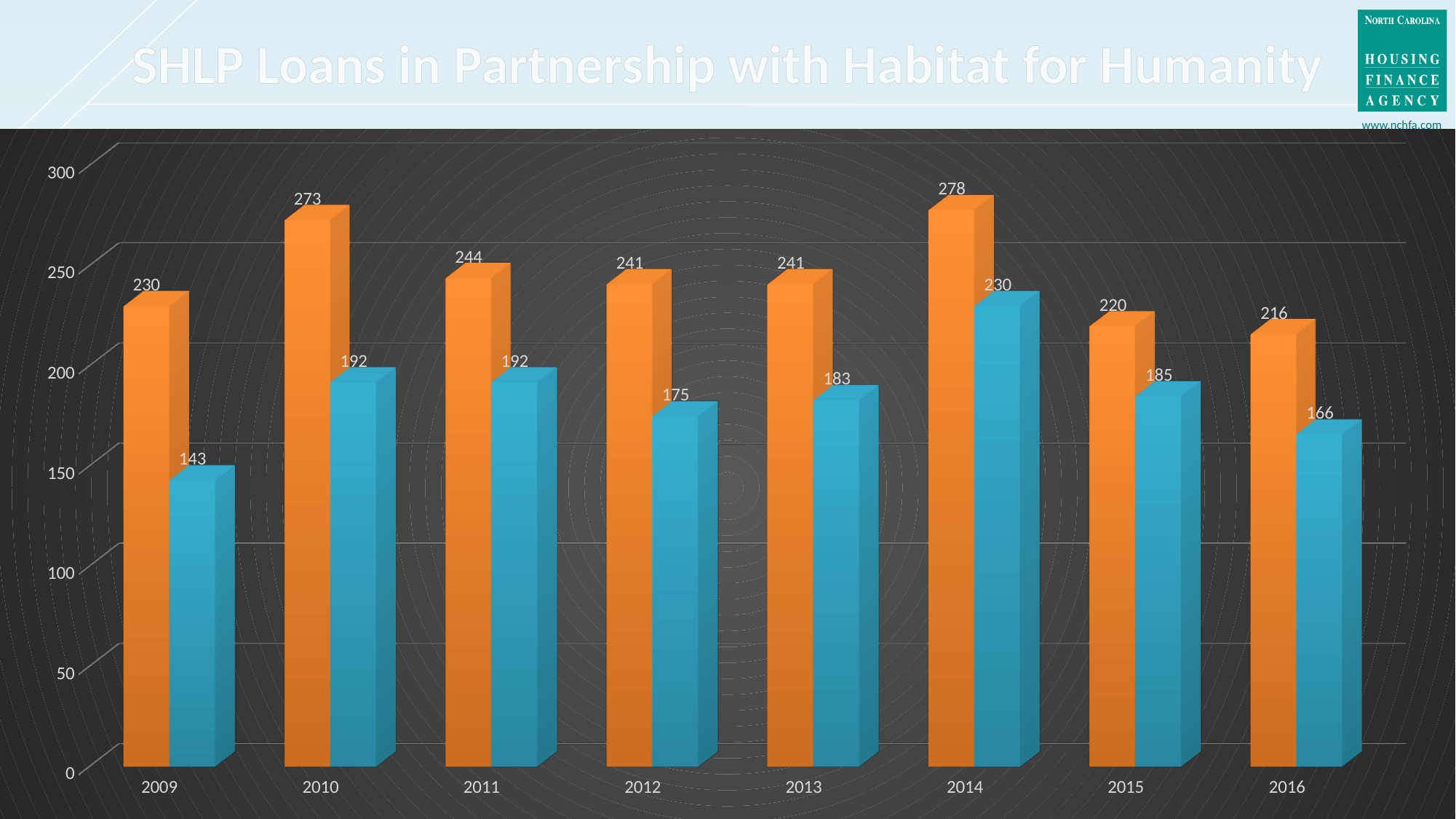
What is the title of the chart? SHLP Loans in Partnership with Habitat for Humanity Which is larger, the blue bar for 2015 or the blue bar for 2016? 2015 What is the value of the blue bar for 2012? 175 Which year has the lowest orange bar? 2016 Which year has the highest orange bar? 2014 What is the value of the blue bar for 2009? 143 What is the value of the orange bar for 2014? 278 What is the difference between the orange bar values for 2010 and 2009? 43 What is the difference between the orange bar and the blue bar for 2014? 48 What kind of chart is shown on the slide? bar chart How many years are shown on the x axis? 8 Which year has the lowest blue bar? 2009